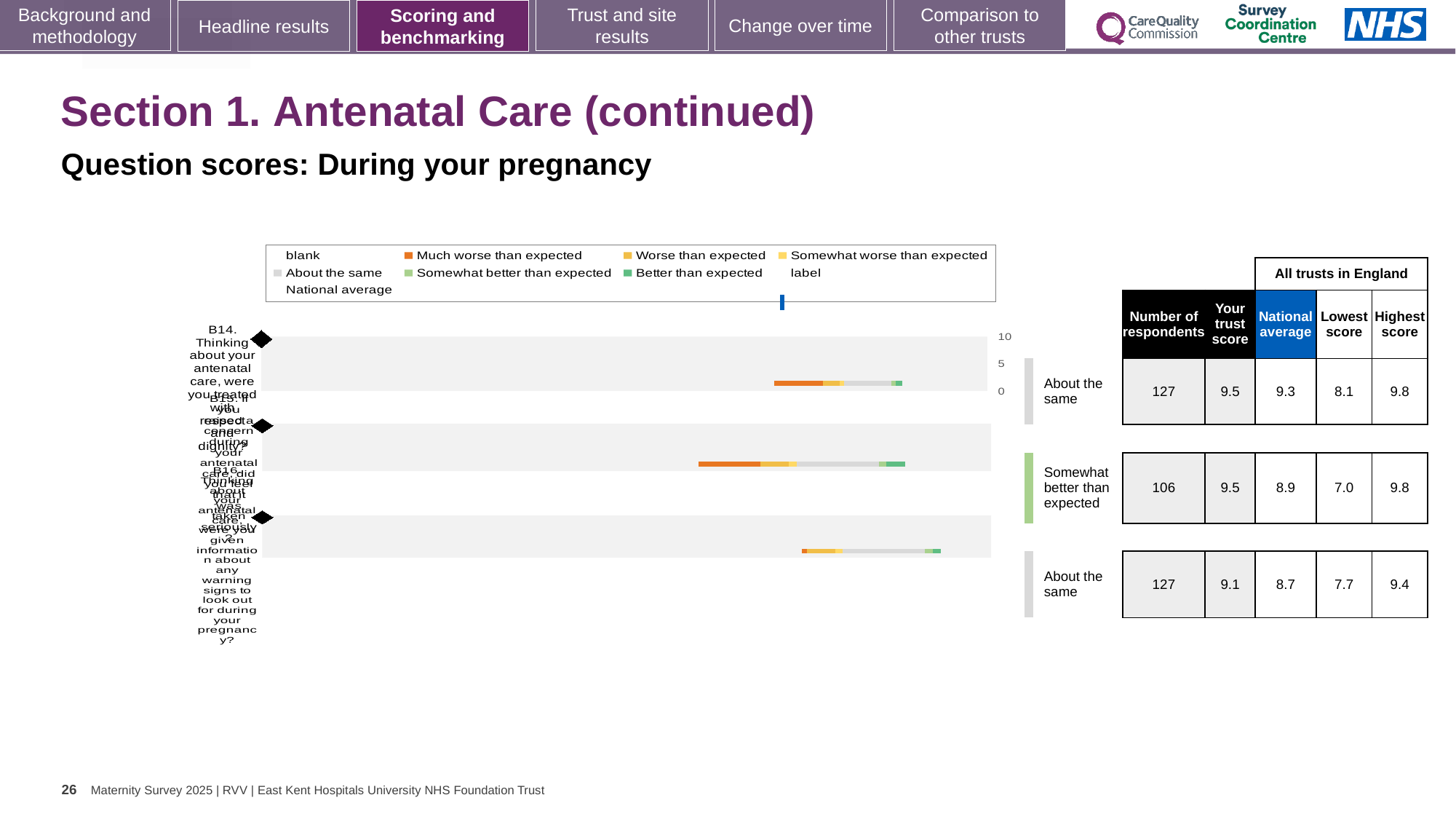
What is the trust score for the second row, rated 'Somewhat better than expected'? 9.5 What kind of chart is shown on the slide? bar chart Is the trust score for the bottom row higher or lower than the trust score for the top row? lower Which row has the fewest respondents? the second row (Somewhat better than expected), 106 What is the number of respondents for the top row (B14, treated with respect and dignity)? 127 What is the national average for the bottom row (B16, information about warning signs)? 8.7 What is the highest score among all trusts in England for the bottom row? 9.4 By how much does the trust score exceed the national average for the second row? 0.6 How many question rows (bars) does the chart show? 3 In the chart legend, what colour represents 'Much worse than expected'? orange What is the lowest score among all trusts in England for the second row? 7.0 What is the highest value shown on the chart's numeric axis? 10